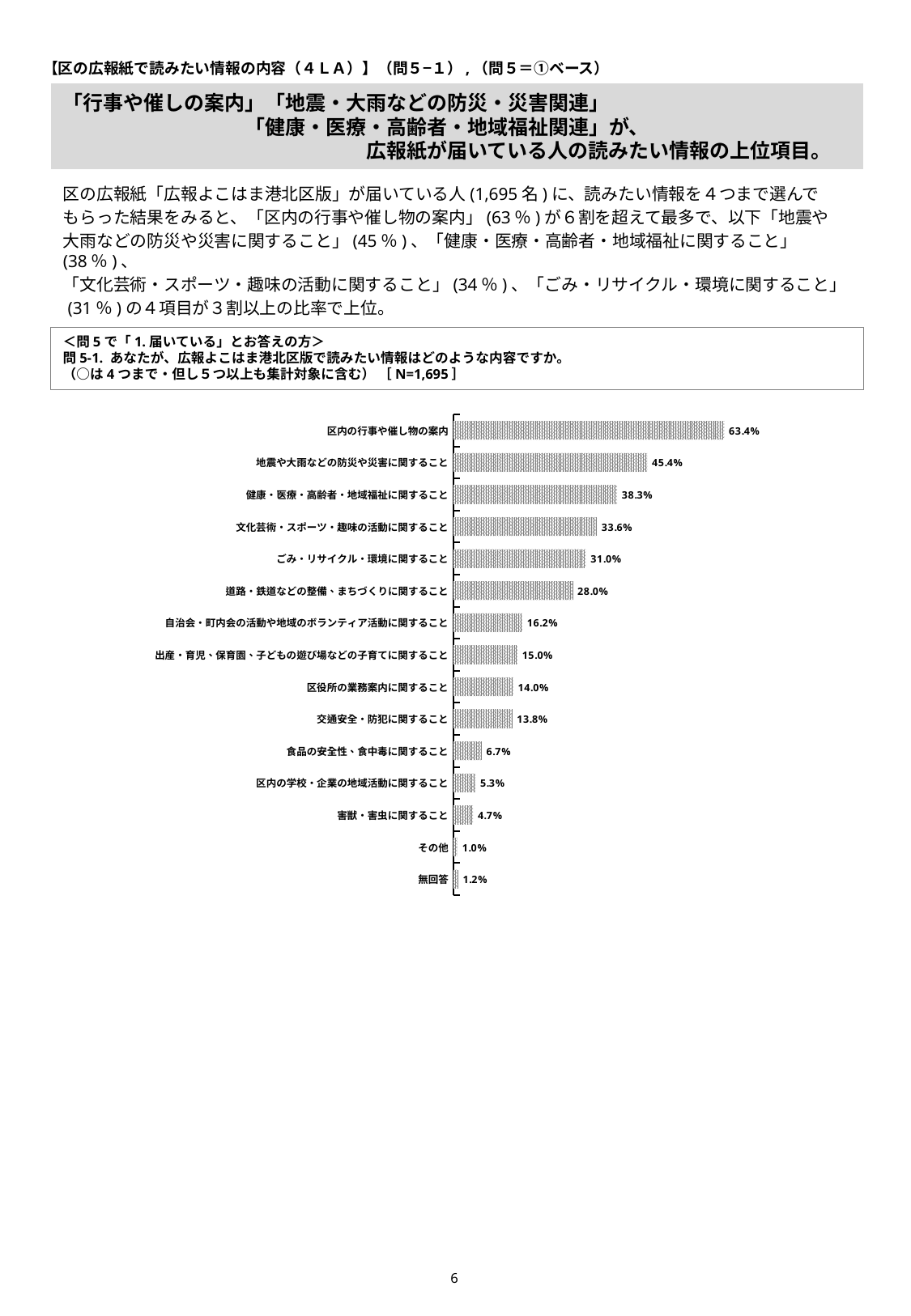
Which category has the lowest value? その他 What is the value for 健康・医療・高齢者・地域福祉に関すること? 38.3% What is the value for 無回答? 1.2% Which category has the highest value? 区内の行事や催し物の案内 What is the sample size (N) stated for the chart? N=1,695 What kind of chart is shown? Bar chart What is the difference between 区内の行事や催し物の案内 and 地震や大雨などの防災や災害に関すること? 18.0% Which is larger, ごみ・リサイクル・環境に関すること or 道路・鉄道などの整備、まちづくりに関すること? ごみ・リサイクル・環境に関すること What is the difference between 食品の安全性、食中毒に関すること and 害獣・害虫に関すること? 2.0% What is the value for 交通安全・防犯に関すること? 13.8% What is the value for 区内の行事や催し物の案内? 63.4% How many categories are shown in the chart? 15